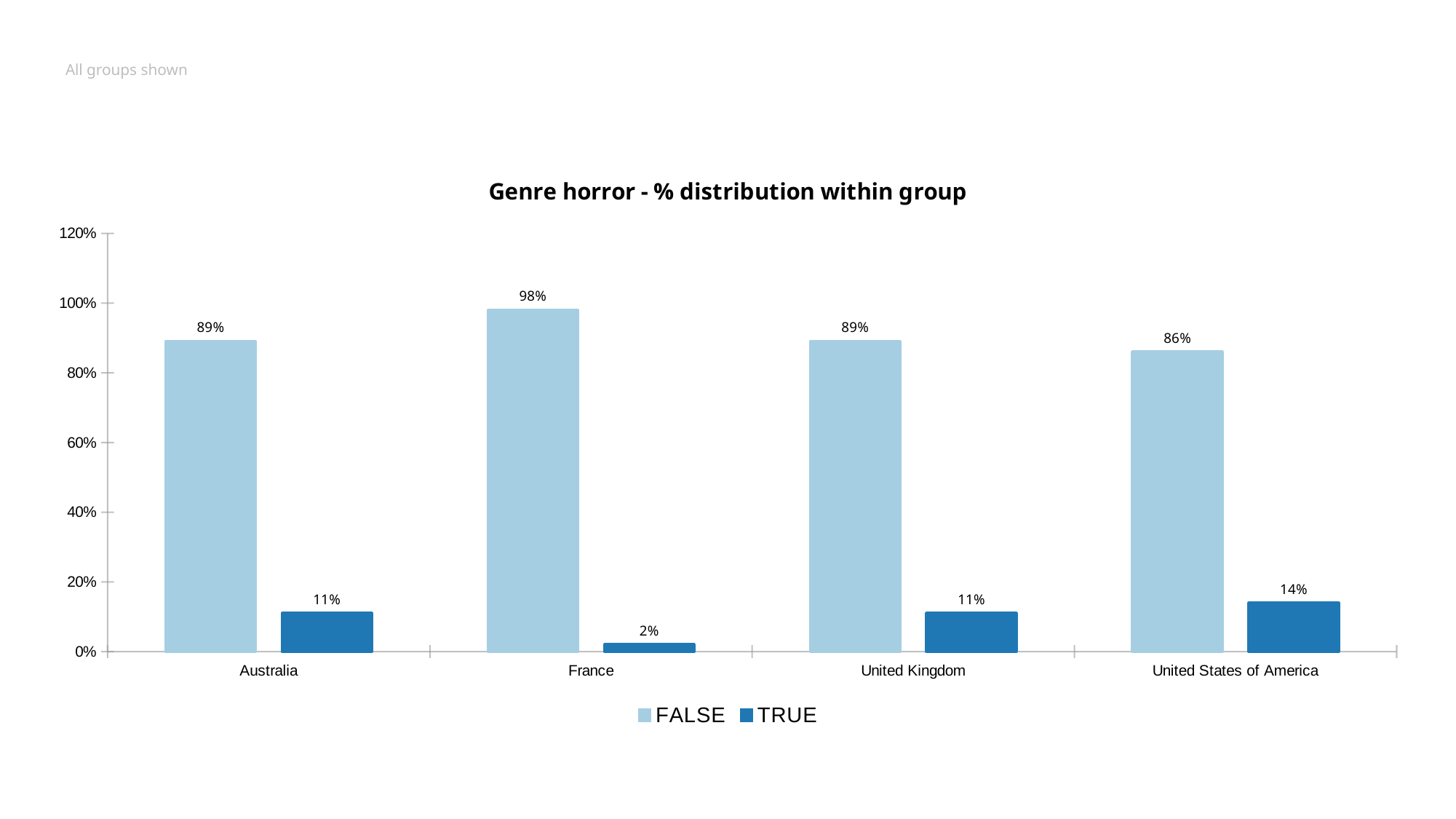
What is the difference between the FALSE value for France and the FALSE value for United States of America? 12% What is the FALSE value for France? 98% What kind of chart is shown on the slide? Bar chart What is the title of the chart? Genre horror - % distribution within group Which country has the highest TRUE value? United States of America How many countries are shown on the x axis? 4 Which country has the highest FALSE value? France Which is larger: the TRUE value for United Kingdom or the TRUE value for United States of America? United States of America How many series does the legend list? 2 What is the TRUE value for United States of America? 14% Which country has the lowest TRUE value? France What is the TRUE value for Australia? 11%